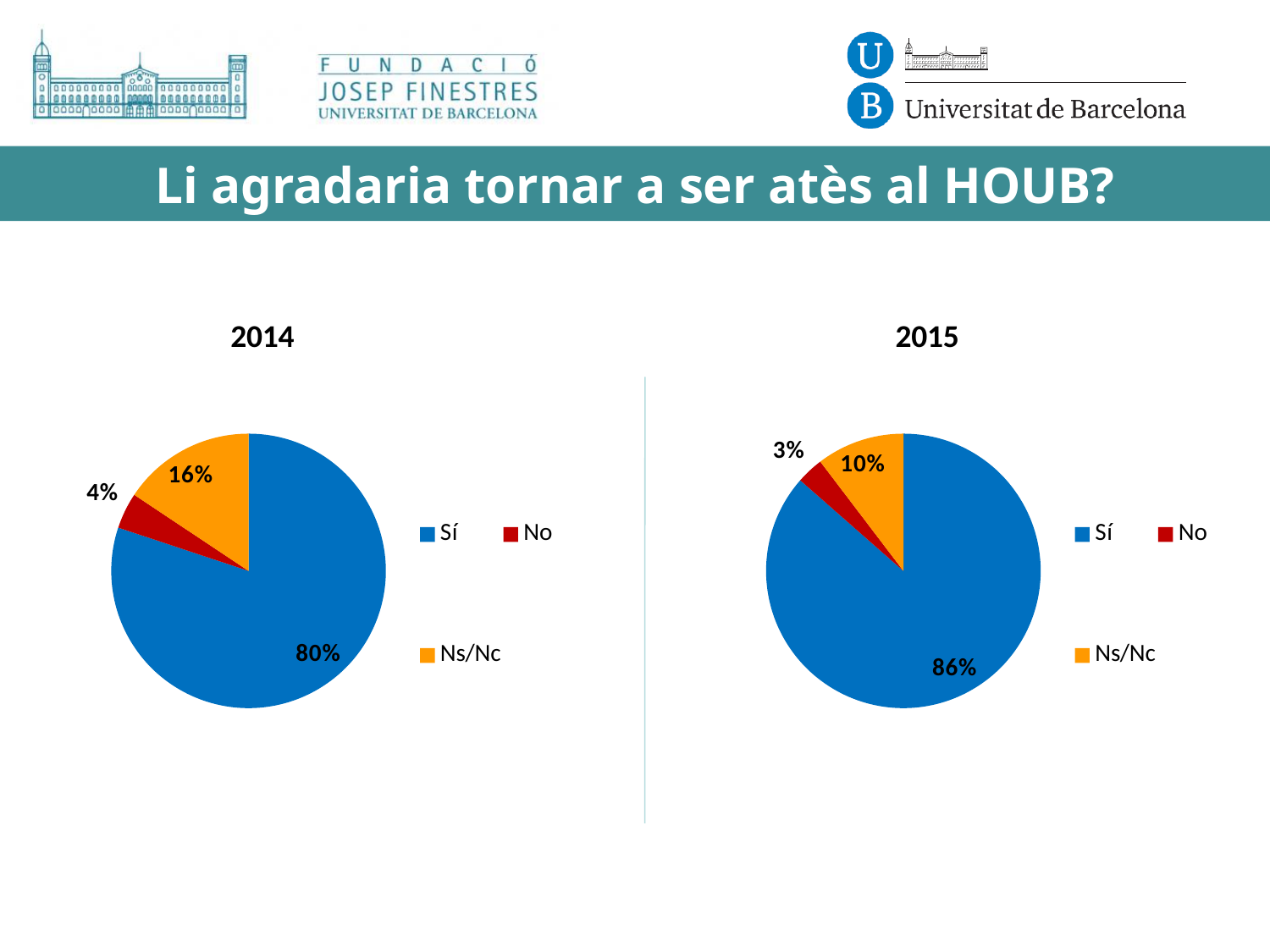
In the 2015 pie chart, what colour represents the Sí category? Blue Is the Ns/Nc share larger in the 2014 chart or the 2015 chart? 2014 In the 2014 pie chart, which category has the largest slice? Sí How many categories does the legend of the 2015 pie chart list? 3 In the 2015 pie chart, what share of respondents answered Sí? 86% In the 2014 pie chart, what percentage is shown for No? 4% In the 2014 pie chart, what share of respondents answered Sí? 80% In the 2015 pie chart, what percentage is shown for Ns/Nc? 10% In the 2015 pie chart, which category has the smallest slice? No What is the difference between the Sí share in 2015 and the Sí share in 2014? 6 percentage points In the 2014 pie chart, what is the difference between the Ns/Nc share and the No share? 12 percentage points What type of chart is used for the 2014 data? Pie chart